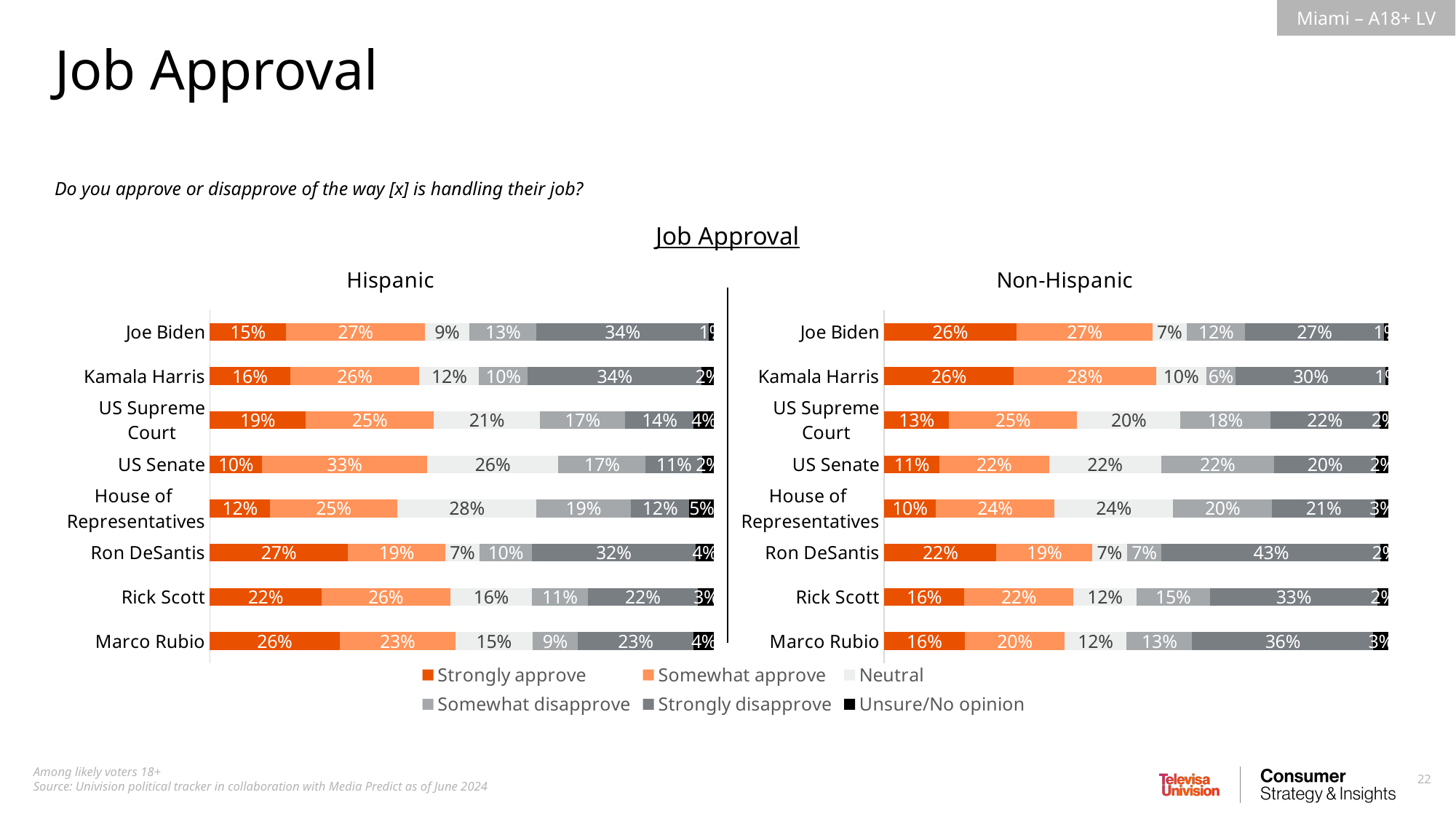
In the Hispanic chart, which category has the highest Strongly approve value? Ron DeSantis What type of chart is used for the Non-Hispanic data? Stacked bar chart In the Non-Hispanic chart, what percentage somewhat approve of Kamala Harris? 28% In the Non-Hispanic chart, which category has the lowest Strongly approve value? House of Representatives How many series does the legend list? 6 In the Non-Hispanic chart, is the Strongly disapprove value larger for Marco Rubio or Rick Scott? Marco Rubio What is the title of the chart on the right side of the slide? Non-Hispanic How many categories are shown in the Hispanic chart? 8 In the Hispanic chart, what is the difference between the Strongly disapprove values for Joe Biden and Ron DeSantis? 2% In the Hispanic chart, what percentage strongly approve of Ron DeSantis? 27% In the Non-Hispanic chart, what percentage strongly disapprove of Ron DeSantis? 43% In the Hispanic chart, what is the Neutral value for the House of Representatives? 28%